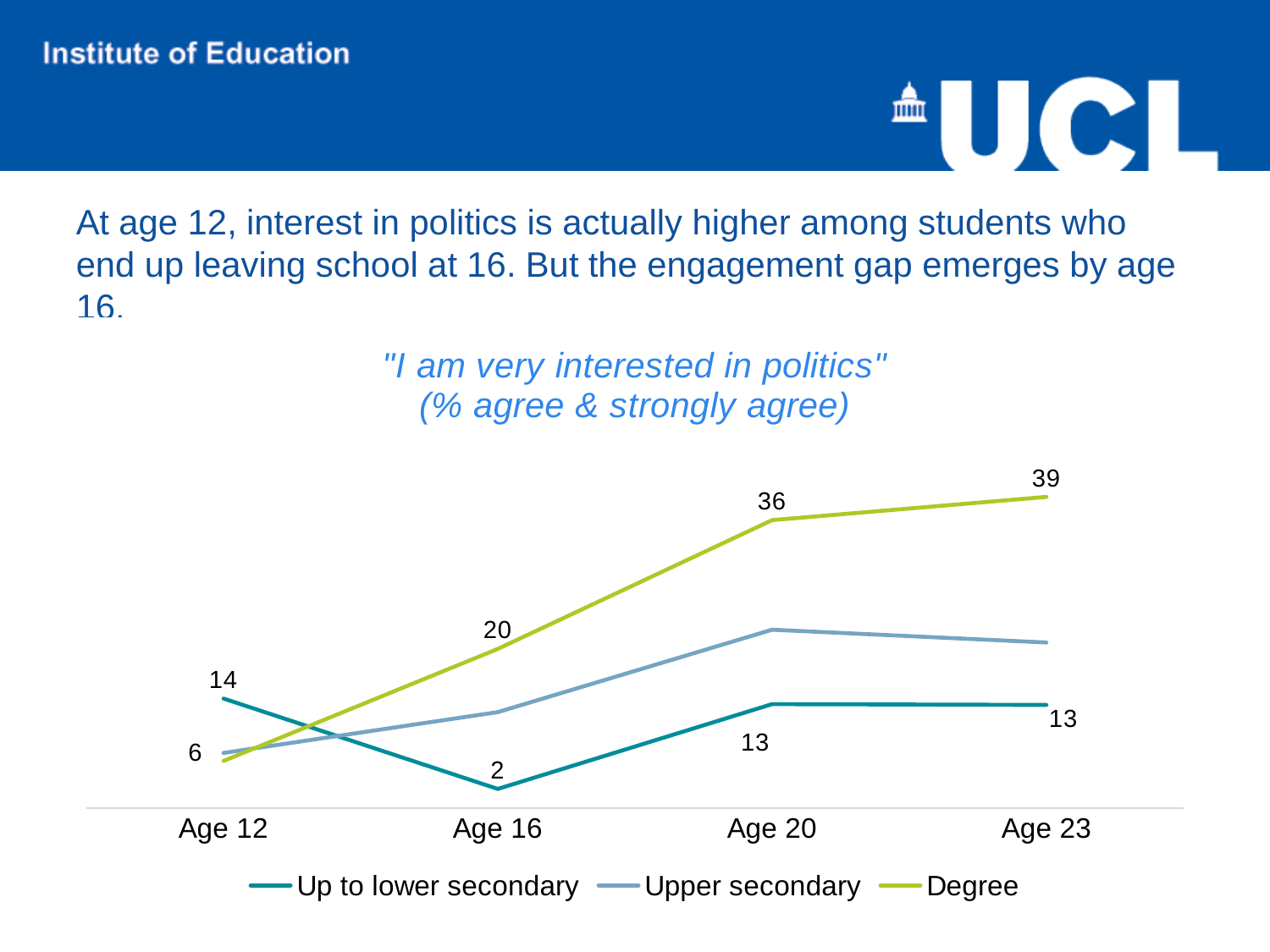
What is the value for Degree at Age 20? 36 At Age 12, which is higher: Up to lower secondary or Degree? Up to lower secondary How many series does the legend list? 3 What is the value for Degree at Age 23? 39 At which age is the Up to lower secondary series at its lowest? Age 16 How many age points are shown on the x axis? 4 At which age does the Degree series reach its highest value? Age 23 What kind of chart is shown on the slide? Line chart What is the value for Up to lower secondary at Age 12? 14 Does the Degree series rise or fall from Age 12 to Age 23? Rise What is the difference between the Degree and Up to lower secondary values at Age 20? 23 What is the value for Up to lower secondary at Age 16? 2